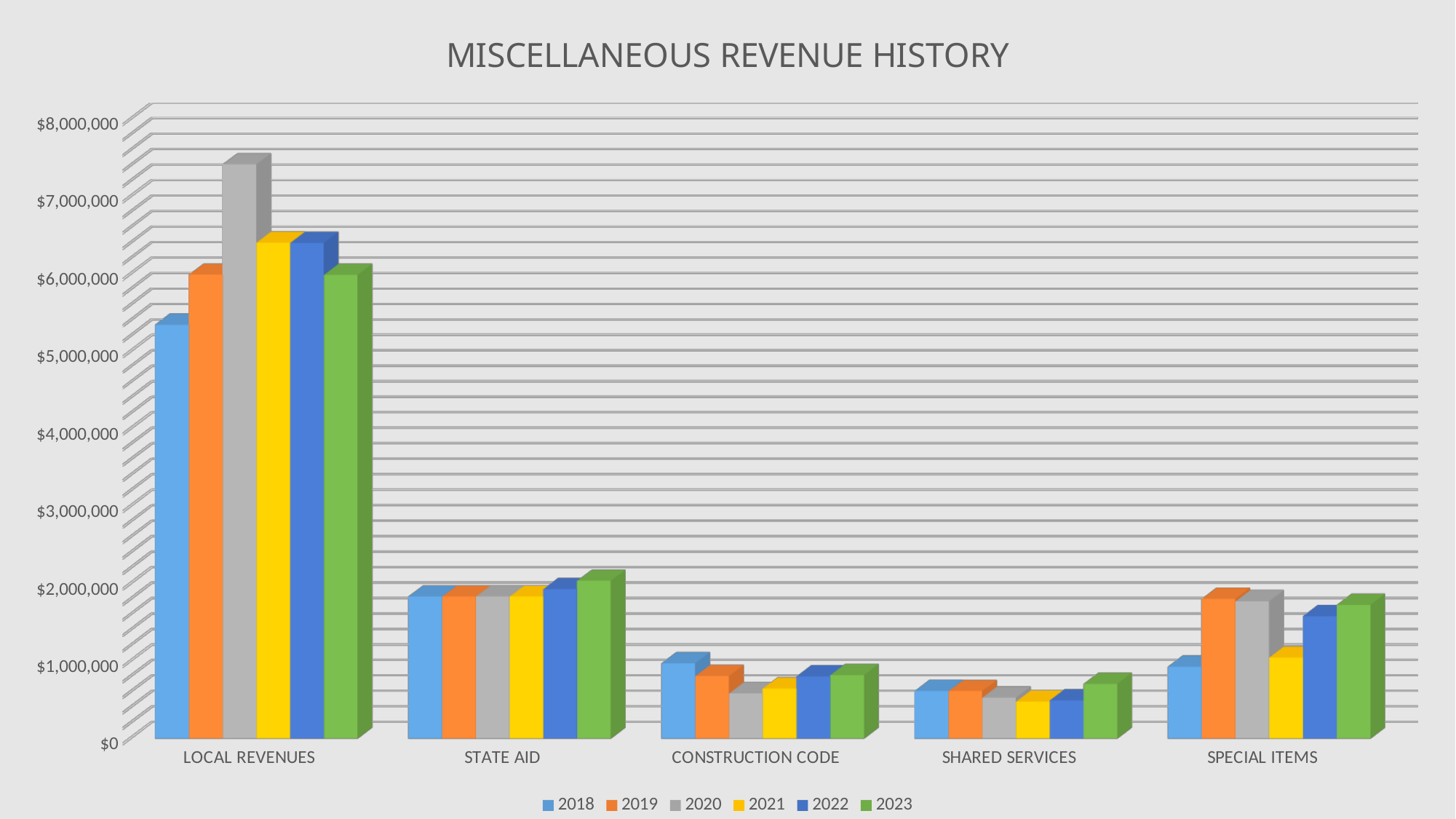
How many series does the legend list? 6 For CONSTRUCTION CODE, which is larger, the 2018 value or the 2020 value? 2018 Is the 2020 value for LOCAL REVENUES greater or less than $7,000,000? greater What kind of chart is shown on the slide? Bar chart For LOCAL REVENUES, which year has the highest bar? 2020 How many categories are shown on the x axis? 5 For LOCAL REVENUES, which year has the lowest bar? 2018 Which category has the lowest values overall? SHARED SERVICES Is the 2020 value for CONSTRUCTION CODE greater or less than $1,000,000? less Which category has the highest values overall? LOCAL REVENUES Do the LOCAL REVENUES values rise or fall from 2018 to 2020? rise What is the title of the chart? MISCELLANEOUS REVENUE HISTORY